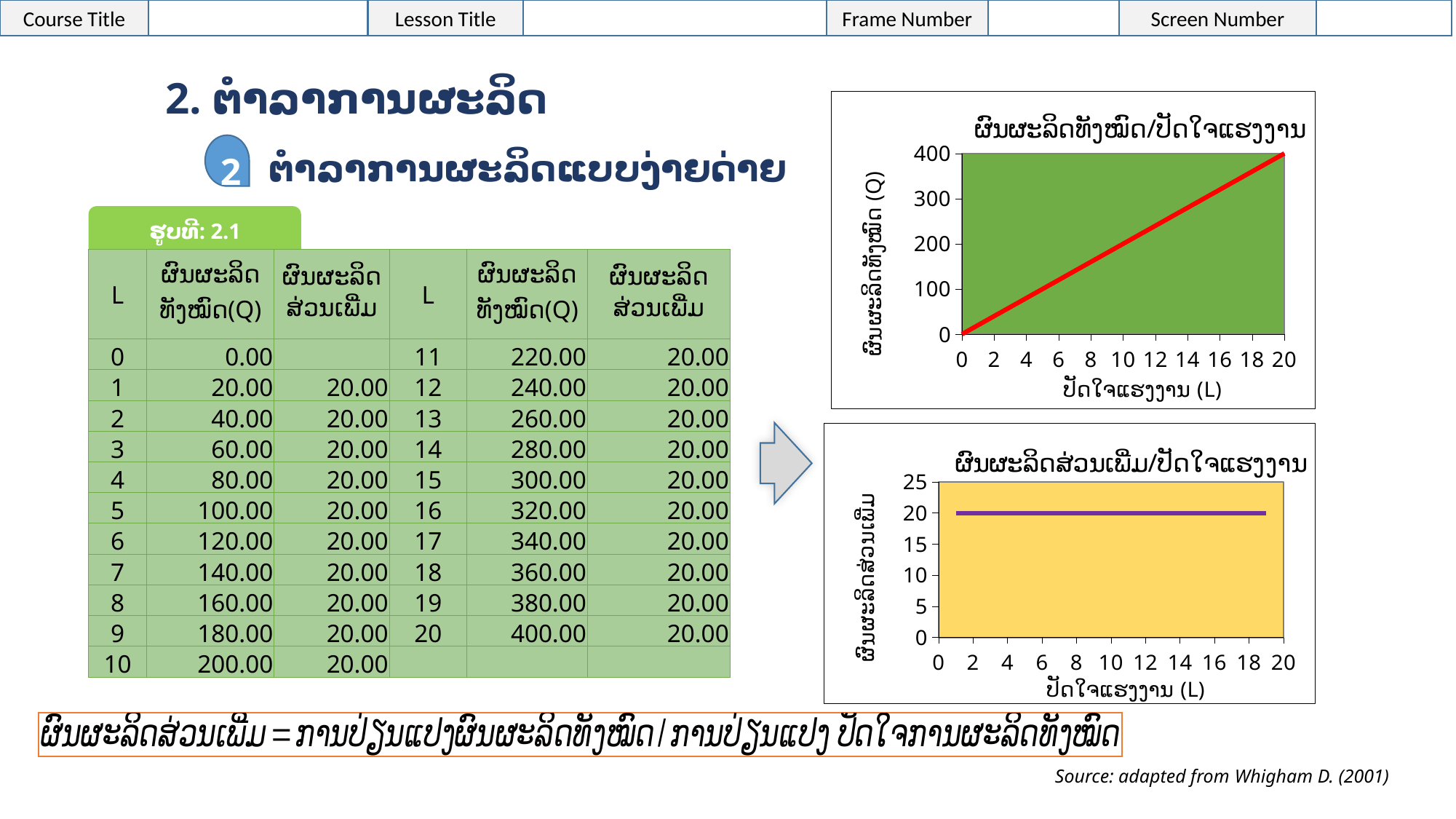
In the bottom chart (ຜົນຜະລິດສ່ວນເພີ່ມ/ປັດໃຈແຮງງານ), is the value at L = 6 greater or less than 15? greater What colour is the plotted line in the top chart (ຜົນຜະລິດທັງໝົດ/ປັດໃຈແຮງງານ)? red In the top chart (ຜົນຜະລິດທັງໝົດ/ປັດໃຈແຮງງານ), is the value at L = 10 greater or less than 300? less In the top chart (ຜົນຜະລິດທັງໝົດ/ປັດໃຈແຮງງານ), is the value at L = 18 greater or less than 300? greater In the top chart (ຜົນຜະລິດທັງໝົດ/ປັດໃຈແຮງງານ), what is the value of ຜົນຜະລິດທັງໝົດ (Q) when L is 0? 0 What is the highest value shown on the y axis of the bottom chart (ຜົນຜະລິດສ່ວນເພີ່ມ/ປັດໃຈແຮງງານ)? 25 In the bottom chart (ຜົນຜະລິດສ່ວນເພີ່ມ/ປັດໃຈແຮງງານ), do the values rise, fall or stay flat as ປັດໃຈແຮງງານ (L) increases? stay flat In the top chart (ຜົນຜະລິດທັງໝົດ/ປັດໃຈແຮງງານ), what is the value of ຜົນຜະລິດທັງໝົດ (Q) when L is 20? 400 What kind of chart is the top chart titled ຜົນຜະລິດທັງໝົດ/ປັດໃຈແຮງງານ? line chart What kind of chart is the bottom chart titled ຜົນຜະລິດສ່ວນເພີ່ມ/ປັດໃຈແຮງງານ? line chart In the bottom chart (ຜົນຜະລິດສ່ວນເພີ່ມ/ປັດໃຈແຮງງານ), what is the value of the line when L is 10? 20 In the top chart (ຜົນຜະລິດທັງໝົດ/ປັດໃຈແຮງງານ), do the values rise or fall as ປັດໃຈແຮງງານ (L) increases? rise